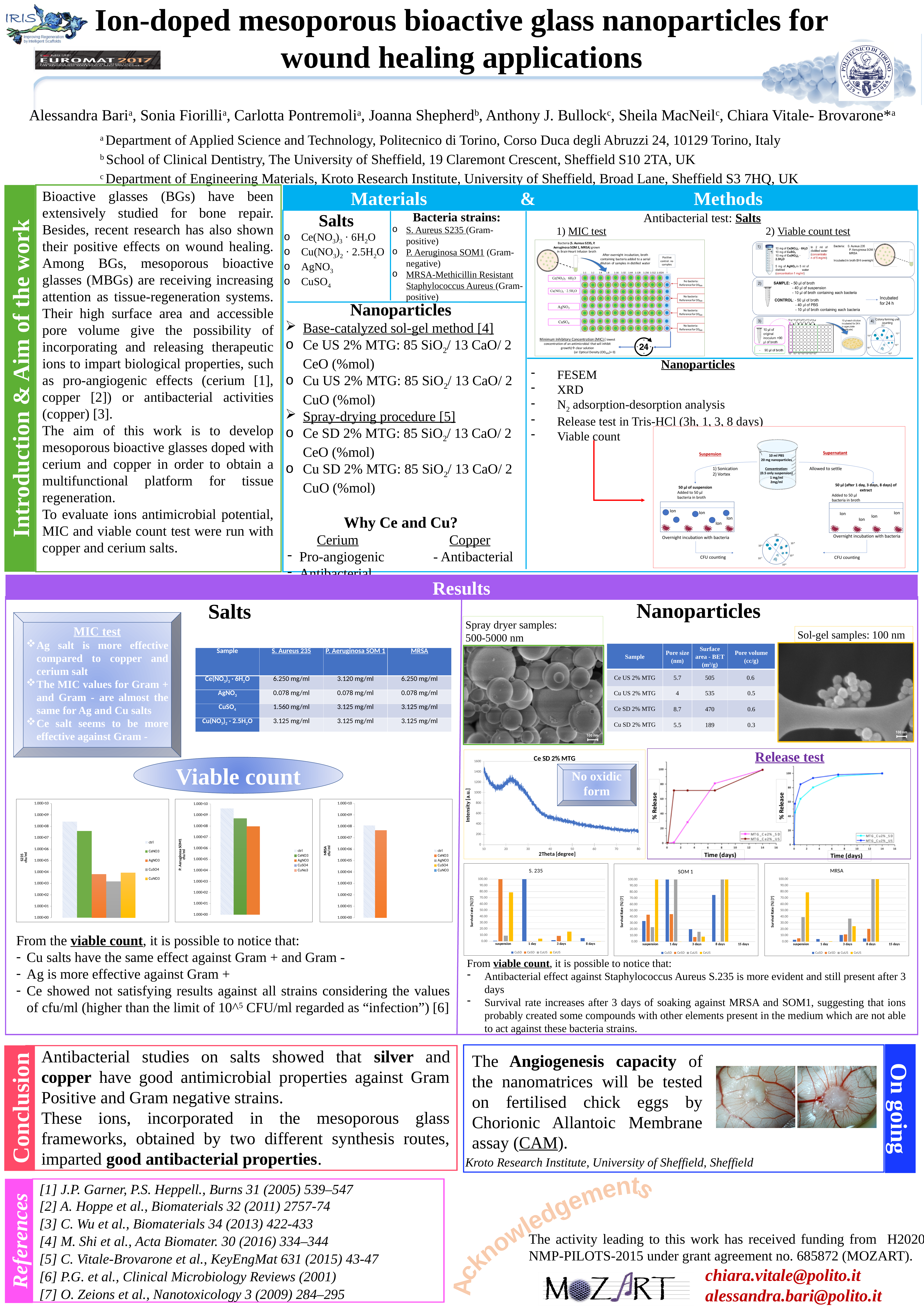
In the leftmost 'Viable count' chart (S235), which series has the highest cfu/ml? ctrl What kind of chart is the 'Ce SD 2% MTG' chart in the Nanoparticles results section? line chart How many series does the legend list in the 'SOM 1' survival rate chart? 4 How many series does the legend list in the leftmost 'Viable count' chart (S235)? 5 In the leftmost 'Viable count' chart (S235), which is larger, the value for CeNO3 or the value for AgNO3? CeNO3 What kind of chart is the 'S. 235' survival rate chart in the Nanoparticles results section? bar chart In the leftmost 'Viable count' chart (S235), is the value for ctrl greater or less than 1.00E+06? greater In the 'Ce SD 2% MTG' chart, does the intensity overall rise or fall as 2Theta increases from 20 to 80 degrees? fall How many time-point categories are shown on the x axis of the 'MRSA' survival rate chart? 5 In the right 'Release test' chart (copper), does the % Release rise or fall over time? rise How many series does the legend list in the left 'Release test' chart (cerium)? 2 In the 'Ce SD 2% MTG' chart, what is the label of the x axis? 2Theta [degree]